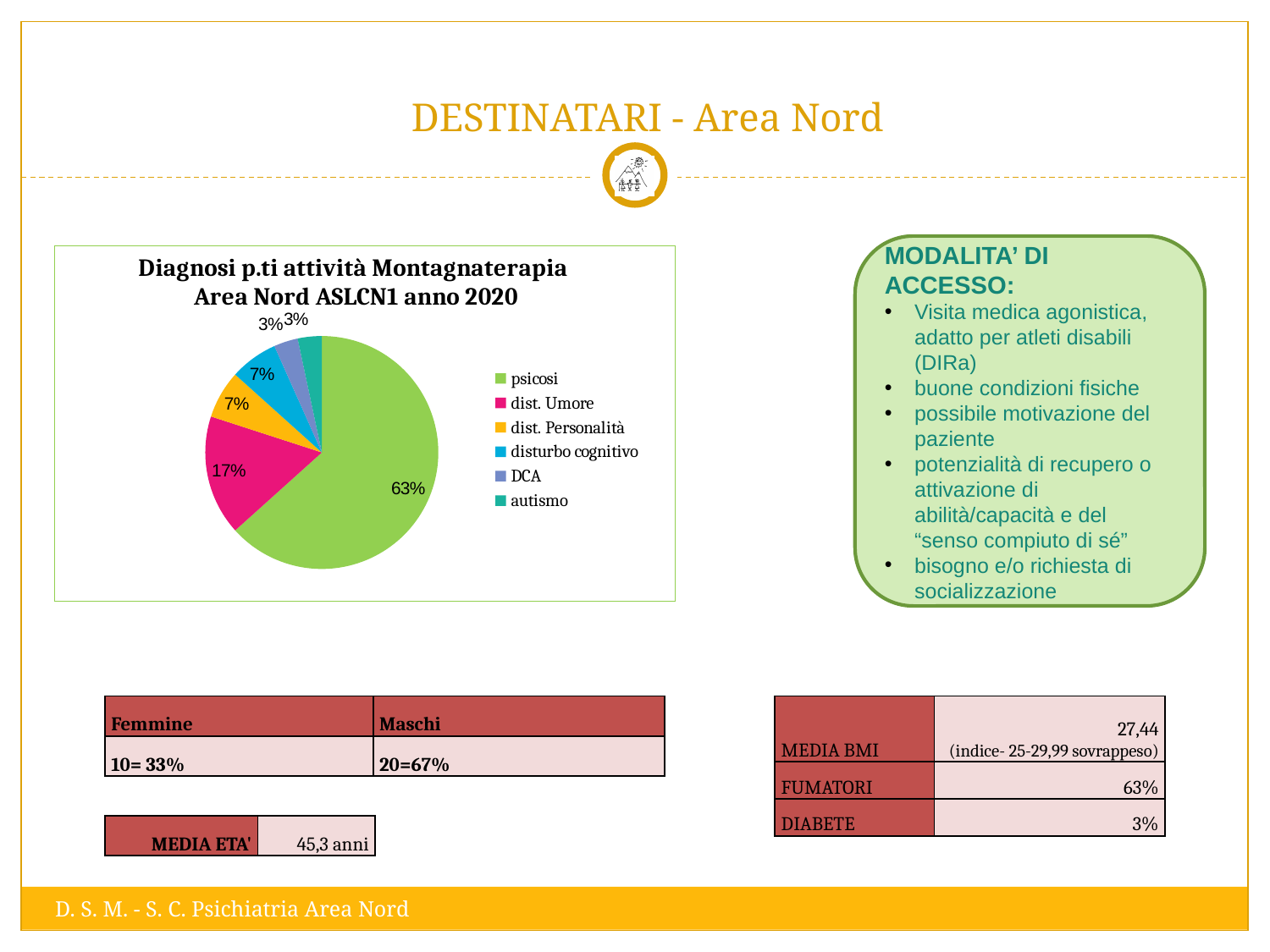
What is the value shown for dist. Umore? 17% What is the title of the chart? Diagnosi p.ti attività Montagnaterapia Area Nord ASLCN1 anno 2020 What percentage is shown for dist. Personalità? 7% Which legend entry is shown in green? psicosi What percentage is shown for DCA? 3% Which is larger, dist. Umore or disturbo cognitivo? dist. Umore How many diagnosis categories are shown in the pie chart? 6 What share of the pie does psicosi represent? 63% Which diagnosis category has the largest slice of the pie? psicosi What type of chart is used to show the diagnoses? pie chart What is the combined share of psicosi and dist. Umore? 80% What is the difference in percentage points between psicosi and dist. Umore? 46